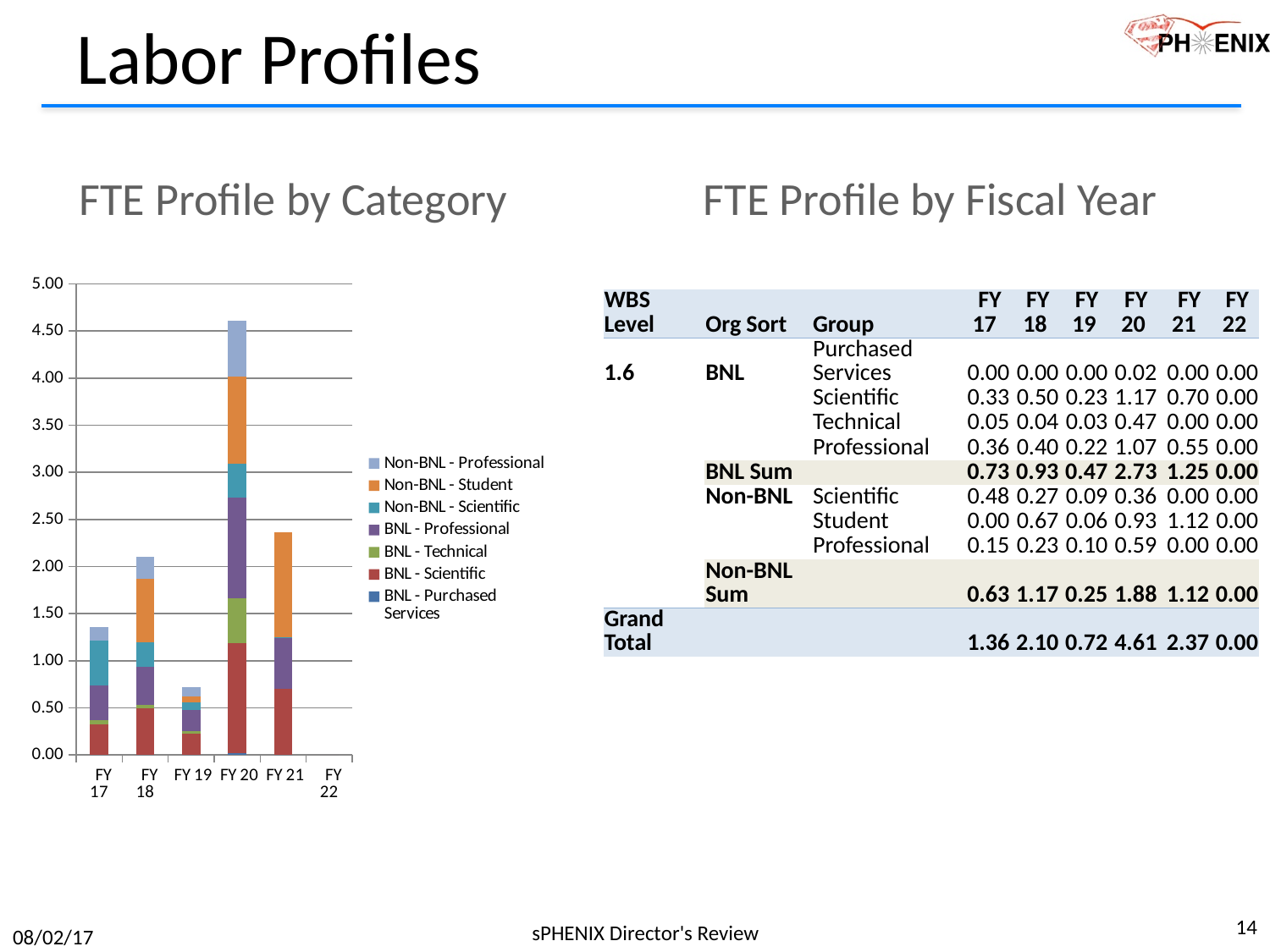
In the FTE Profile by Category chart, what colour represents the Non-BNL - Student series? orange What is the title of the chart on the slide? FTE Profile by Category In the FTE Profile by Category chart, is the total for FY 19 greater or less than 1.00? less In the FTE Profile by Category chart, which fiscal year has the lowest total FTE? FY 22 In the FTE Profile by Category chart, is the total for FY 21 greater or less than 2.00? greater In the FTE Profile by Category chart, which has the larger total, FY 17 or FY 18? FY 18 What kind of chart is the FTE Profile by Category chart? bar chart In the FTE Profile by Category chart, is the total for FY 17 greater or less than 1.50? less How many series does the legend of the FTE Profile by Category chart list? 7 How many fiscal years are shown on the x axis of the FTE Profile by Category chart? 6 In the FTE Profile by Category chart, which fiscal year has the tallest stacked bar? FY 20